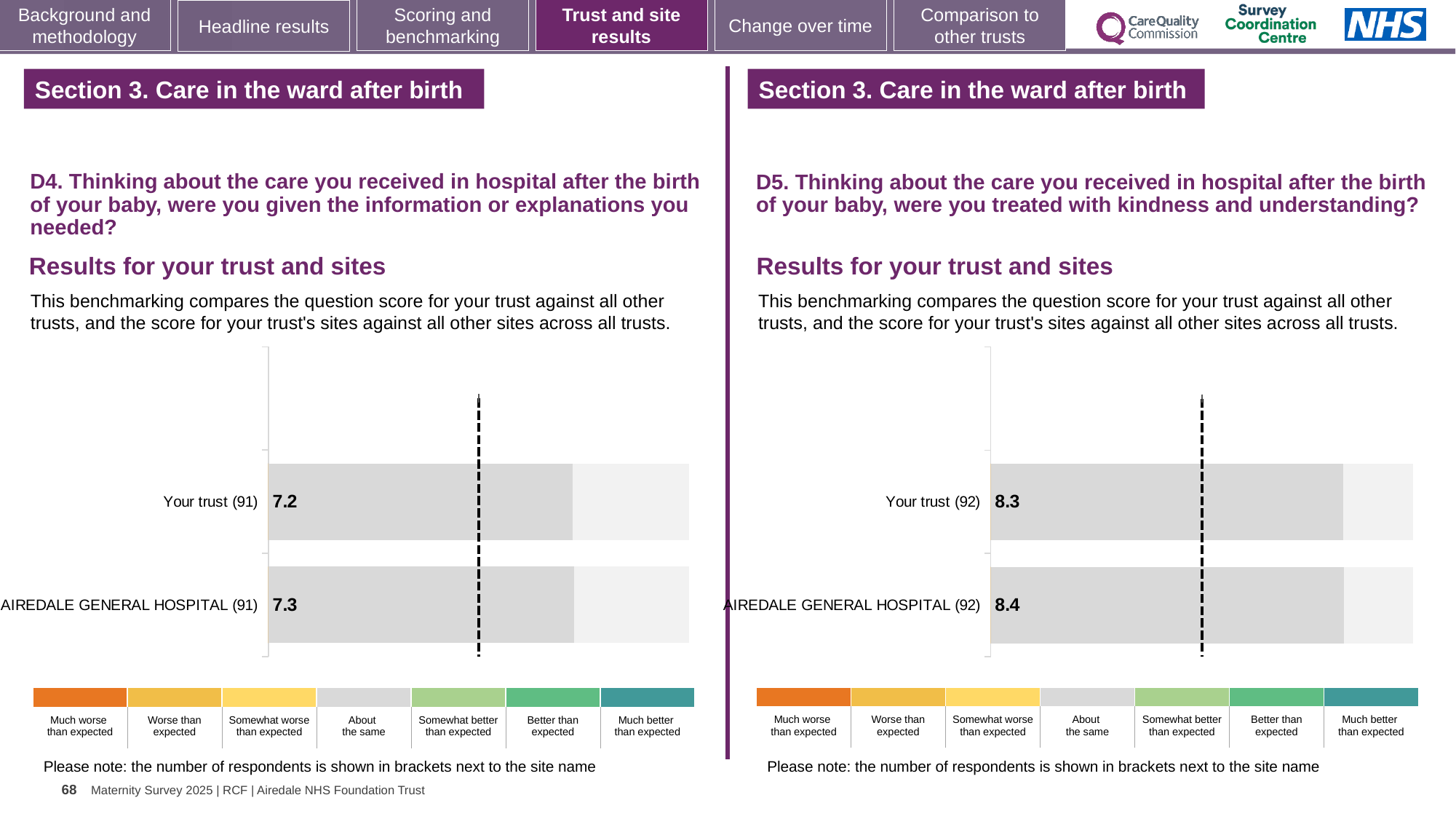
How many bars are plotted in the D5 chart on the right? 2 What kind of chart is used for the D4 results on the left? Bar chart Which is larger: the Your trust score in the D4 chart on the left or the Your trust score in the D5 chart on the right? D5 chart (8.3) In the D4 chart on the left, what is the score for AIREDALE GENERAL HOSPITAL (91)? 7.3 In the D4 chart on the left, what is the score for Your trust (91)? 7.2 In the D5 chart on the right, what is the difference between the AIREDALE GENERAL HOSPITAL score and the Your trust score? 0.1 In the D5 chart on the right, what is the score for AIREDALE GENERAL HOSPITAL (92)? 8.4 In the D4 chart on the left, what is the difference between the AIREDALE GENERAL HOSPITAL score and the Your trust score? 0.1 In the D4 chart on the left, how many respondents are shown in brackets for Your trust? 91 In the D5 chart on the right, what is the score for Your trust (92)? 8.3 In the D5 chart on the right, how many respondents are shown in brackets for AIREDALE GENERAL HOSPITAL? 92 How many bars are plotted in the D4 chart on the left? 2